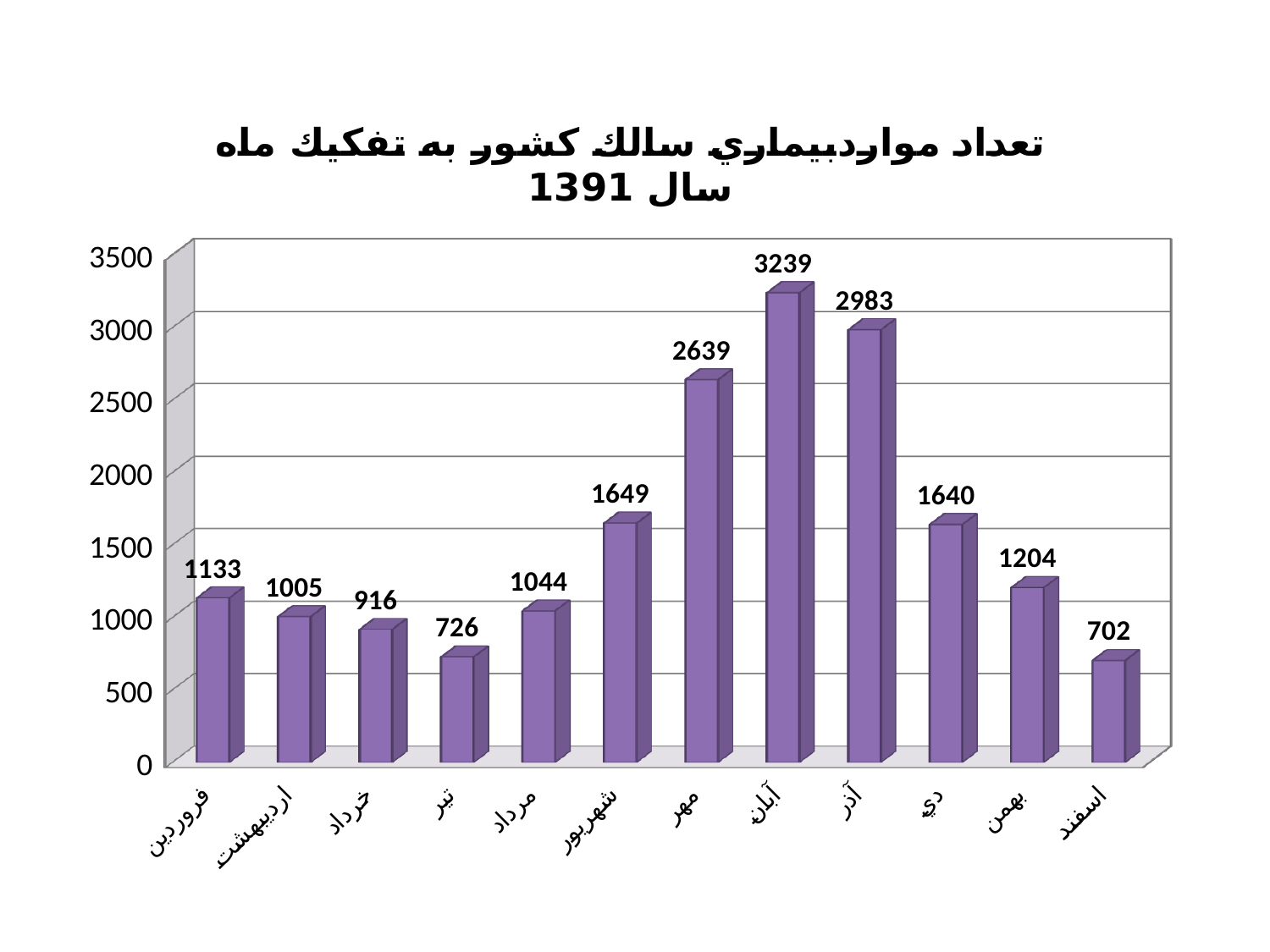
What is the value for شهریور? 1649 Which is larger, the value for فروردین or the value for بهمن? بهمن What kind of chart is shown on the slide? bar chart What is the value for تیر? 726 How many months are shown on the x axis? 12 What is the difference between the values for آبان and آذر? 256 What is the value for آبان? 3239 What is the difference between the values for مهر and شهریور? 990 Do the values rise or fall from آبان to اسفند? fall Is the value for دی greater or less than 1500? greater Which month has the lowest value? اسفند Which month has the highest value? آبان